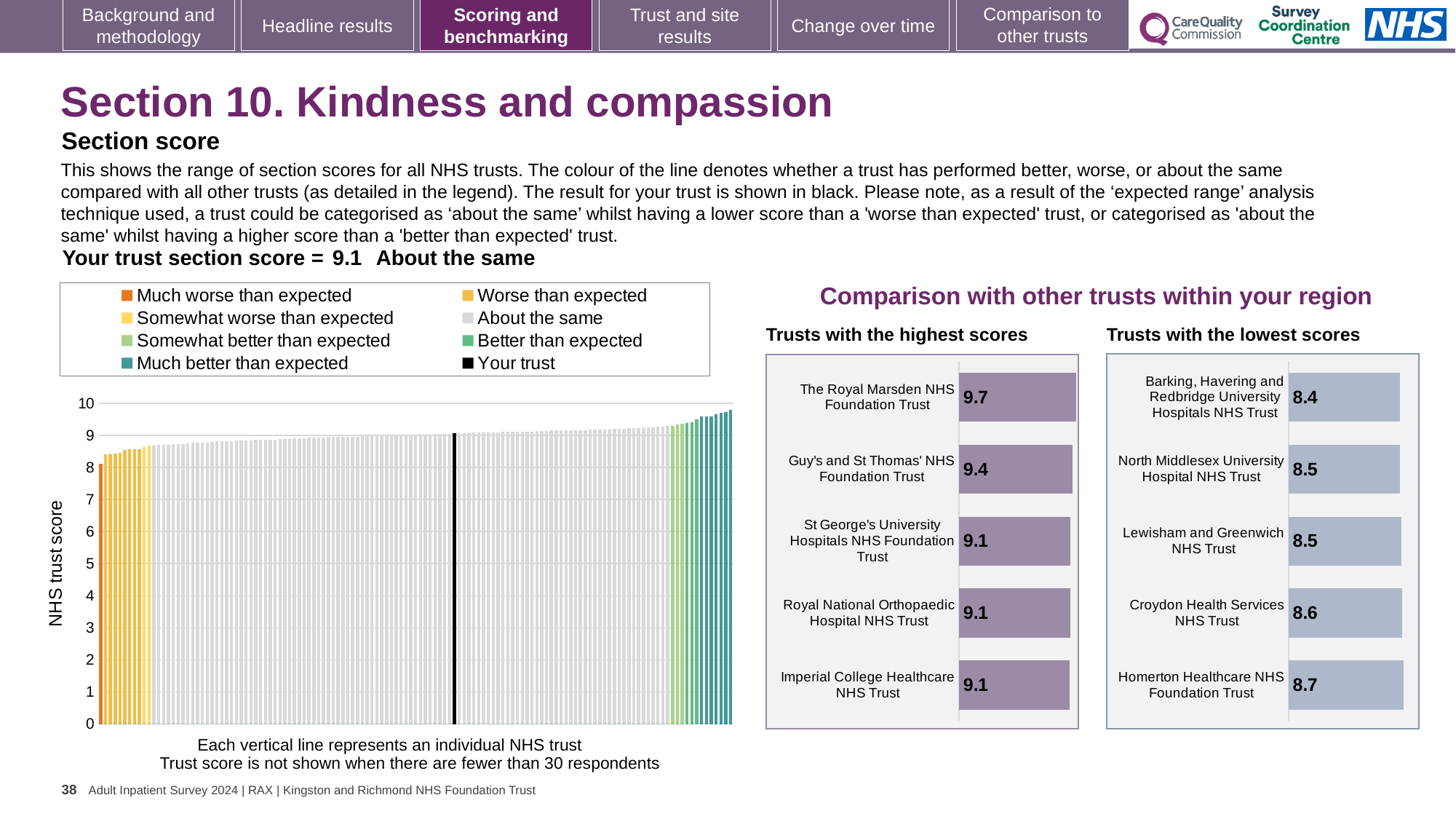
What kind of chart is the NHS trust score chart on the left of the slide? bar chart In the 'Trusts with the highest scores' chart, what is the difference between the scores of The Royal Marsden NHS Foundation Trust and Guy's and St Thomas' NHS Foundation Trust? 0.3 In the NHS trust score chart on the left, do the values rise or fall from left to right along the x axis? rise In the 'Trusts with the lowest scores' chart, what is the score for Homerton Healthcare NHS Foundation Trust? 8.7 In the 'Trusts with the lowest scores' chart, what is the difference between the scores of Homerton Healthcare NHS Foundation Trust and Barking, Havering and Redbridge University Hospitals NHS Trust? 0.3 In the 'Trusts with the highest scores' chart, which trust has the highest score? The Royal Marsden NHS Foundation Trust In the NHS trust score chart on the left, what colour is used for 'Your trust' according to the legend? black In the 'Trusts with the highest scores' chart, what is the score for The Royal Marsden NHS Foundation Trust? 9.7 In the 'Trusts with the lowest scores' chart, which trust has the lowest score? Barking, Havering and Redbridge University Hospitals NHS Trust How many trusts are shown in the 'Trusts with the highest scores' chart? 5 How many entries does the legend of the NHS trust score chart on the left list? 8 In the 'Trusts with the lowest scores' chart, which has the larger score: Croydon Health Services NHS Trust or North Middlesex University Hospital NHS Trust? Croydon Health Services NHS Trust